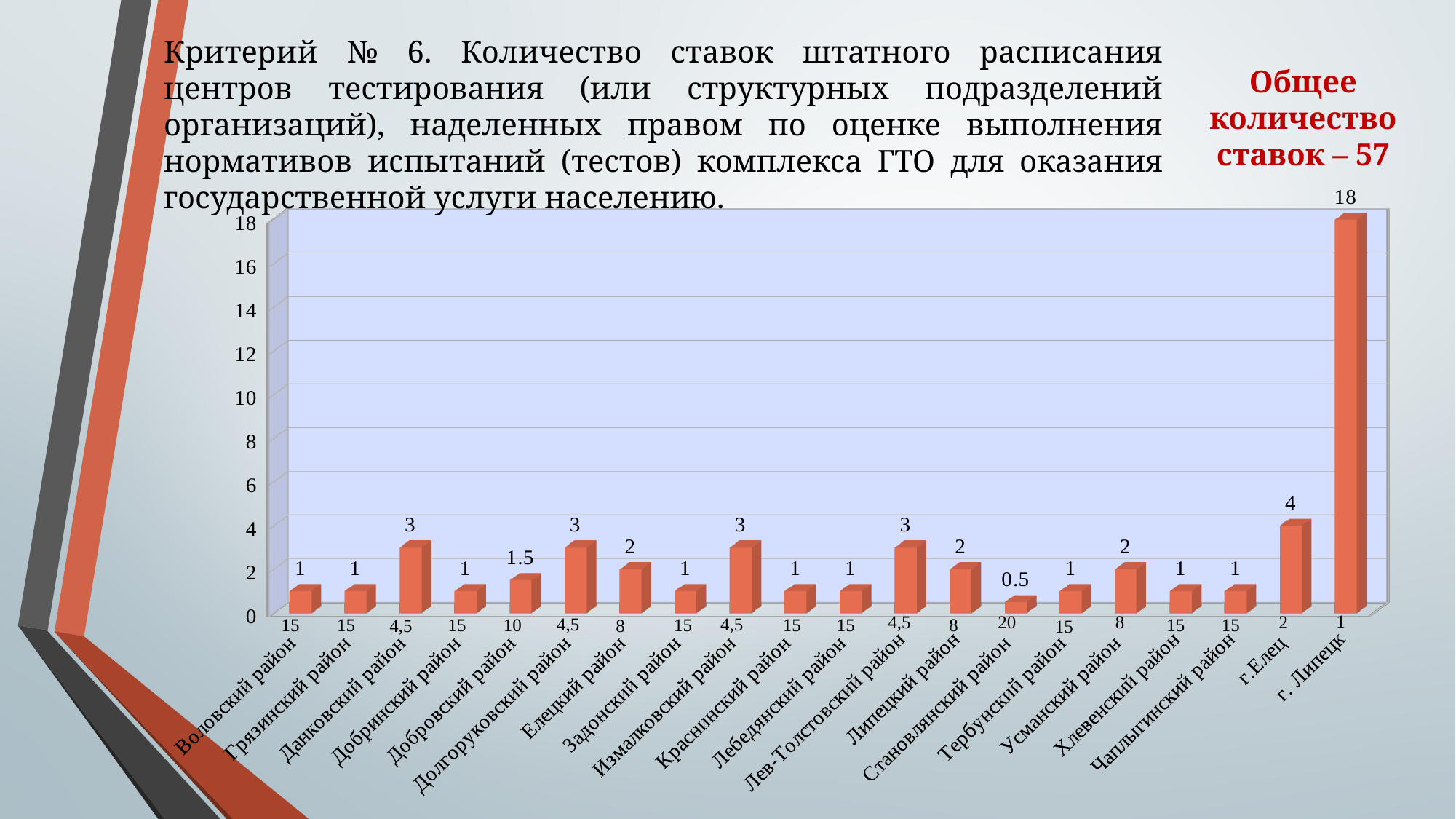
What kind of chart is shown on the slide? bar chart Which is larger, the value for Данковский район or the value for Липецкий район? Данковский район What is the value for Становлянский район? 0.5 How many categories are shown on the x axis? 20 Which category has the lowest value? Становлянский район What is the value for г. Липецк? 18 What is the value for г.Елец? 4 What is the value for Добровский район? 1.5 What is the difference between the values for г. Липецк and г.Елец? 14 What total number of ставок is stated in red text on the slide? 57 Which category has the highest value? г. Липецк Is the value for г. Липецк greater or less than 16? greater